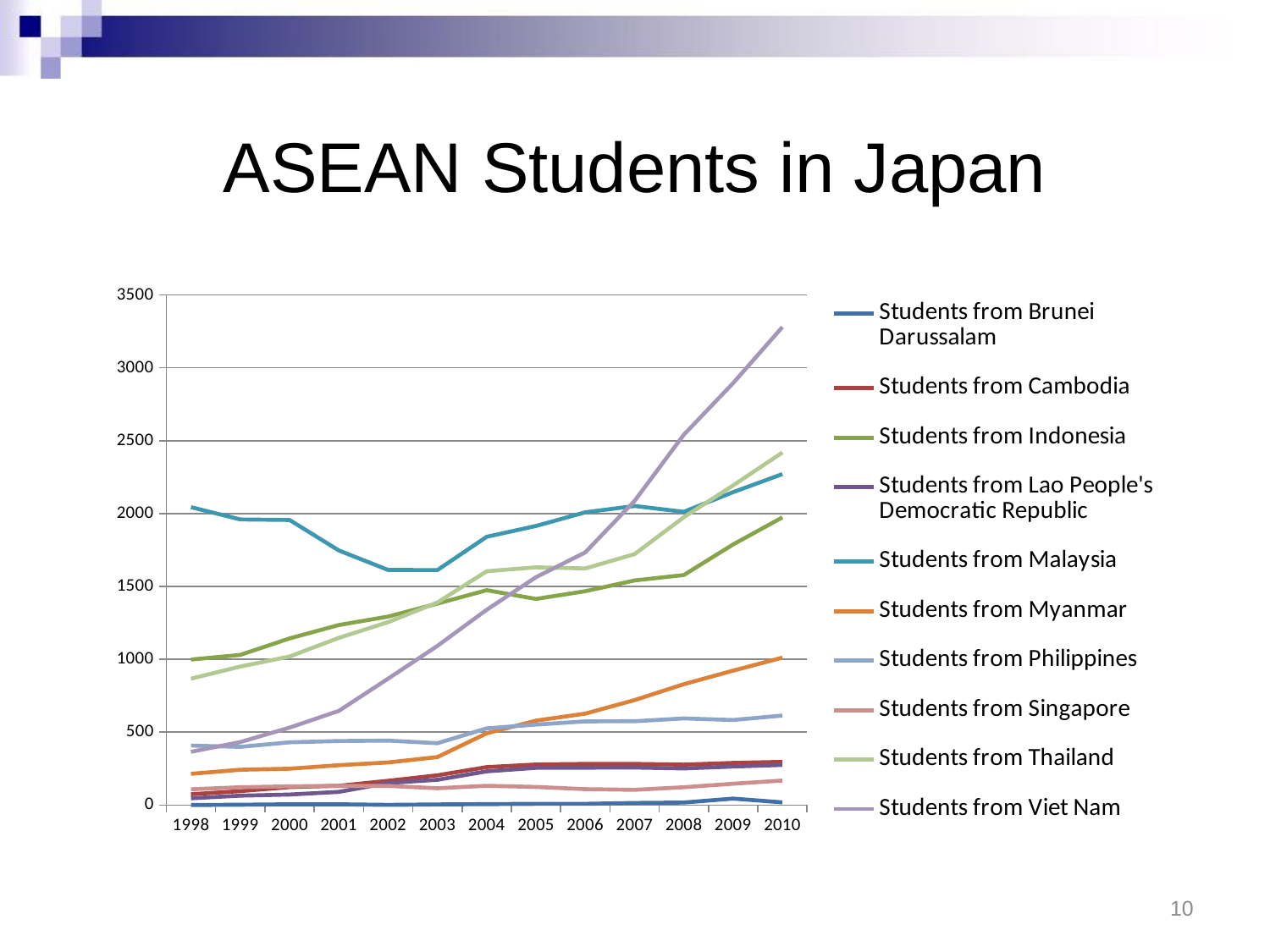
Which series has the lowest value in 2010? Students from Brunei Darussalam Is the value for Students from Malaysia in 2002 greater or less than 2000? less What is the title of the chart? ASEAN Students in Japan Do the values for Students from Viet Nam rise or fall from 1998 to 2010? rise How many years are shown along the x axis? 13 How many series does the legend list? 10 Which series has the highest value in 1998? Students from Malaysia Is the value for Students from Viet Nam in 2010 greater or less than 3000? greater Which series has the highest value in 2010? Students from Viet Nam Is the value for Students from Myanmar in 2010 greater or less than 500? greater What kind of chart is shown on the slide? line chart In 2010, which is larger: Students from Thailand or Students from Indonesia? Students from Thailand